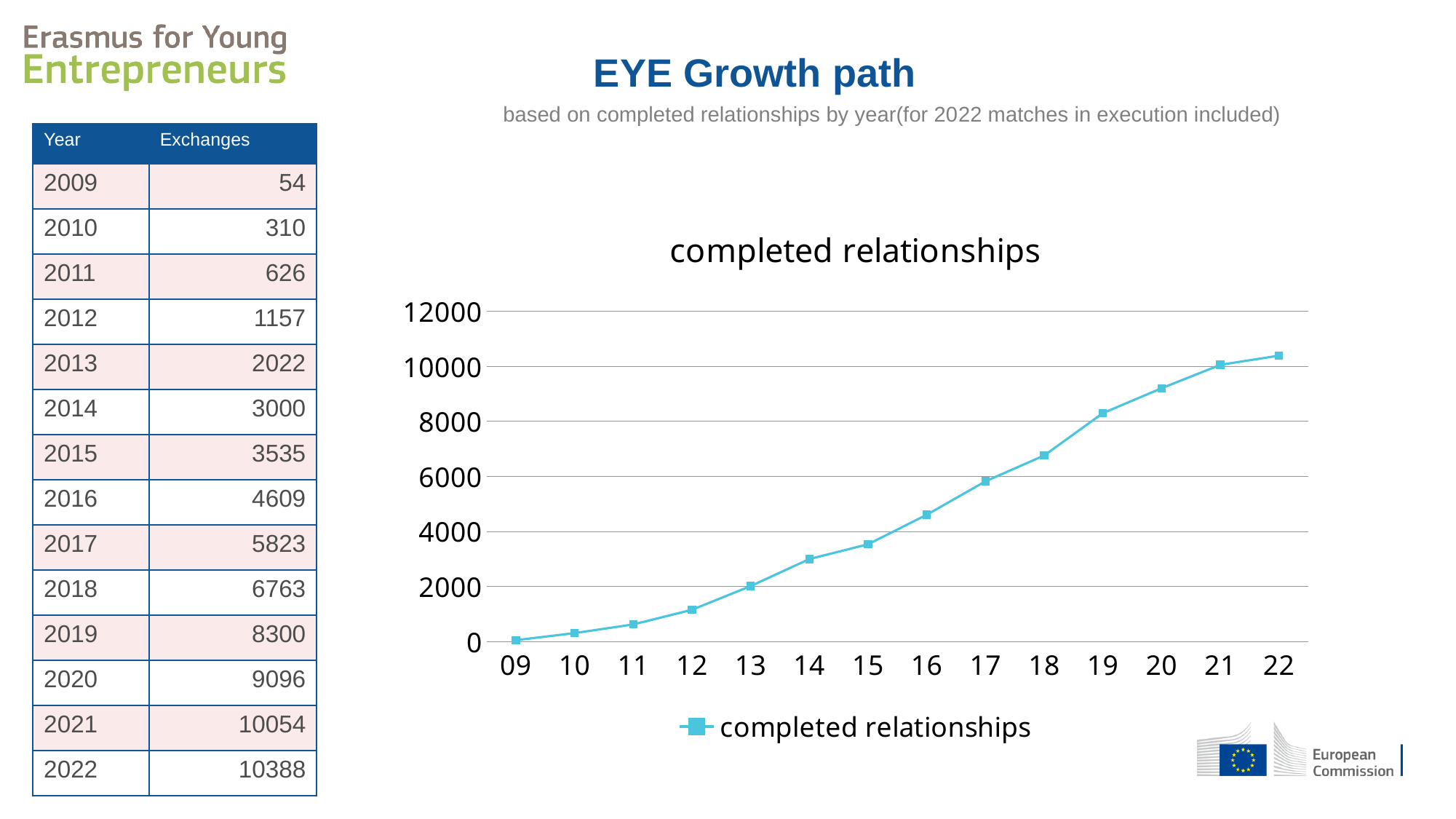
Which year has the highest number of completed relationships? 22 What kind of chart is shown on the slide? line chart According to the table on the slide, how many exchanges were there in 2022? 10388 How many series does the chart legend list? 1 Which year has the lowest number of completed relationships? 09 Do the values of completed relationships rise or fall from 09 to 22? rise What is the title of the chart? completed relationships Which is larger, the value for 17 or the value for 14? 17 How many years are plotted along the x axis of the chart? 14 Is the value for 19 greater or less than 8000? greater Is the value for 15 greater or less than 4000? less